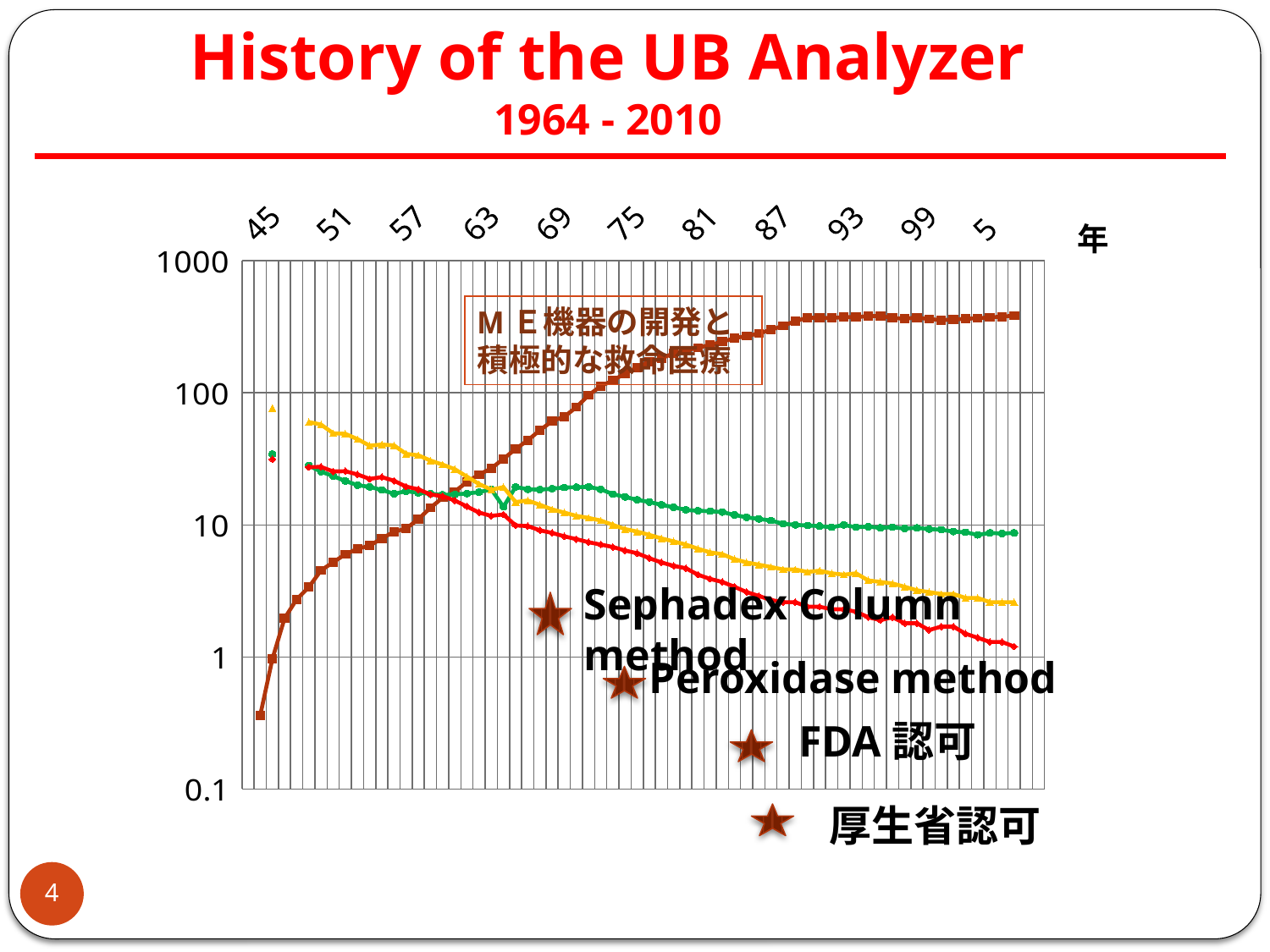
Which line has the lowest value at the right end of the chart (year 5)? the red line At year 93, which line has the larger value, the brown line or the green line? the brown line Is the value of the brown line at year 45 greater or less than 1? less Does the red line rise or fall from year 51 to year 5 along the x axis? fall Does the yellow triangle-marker line rise or fall from year 51 to year 5? fall How many year labels are shown along the x axis? 11 At year 5, which line has the larger value, the green line or the red line? the green line Is the value of the green line at year 75 greater or less than 10? greater Does the brown square-marker line rise or fall from year 45 to year 5 along the x axis? rise What kind of chart is shown on the slide? line chart Is the value of the brown line at year 93 greater or less than 100? greater